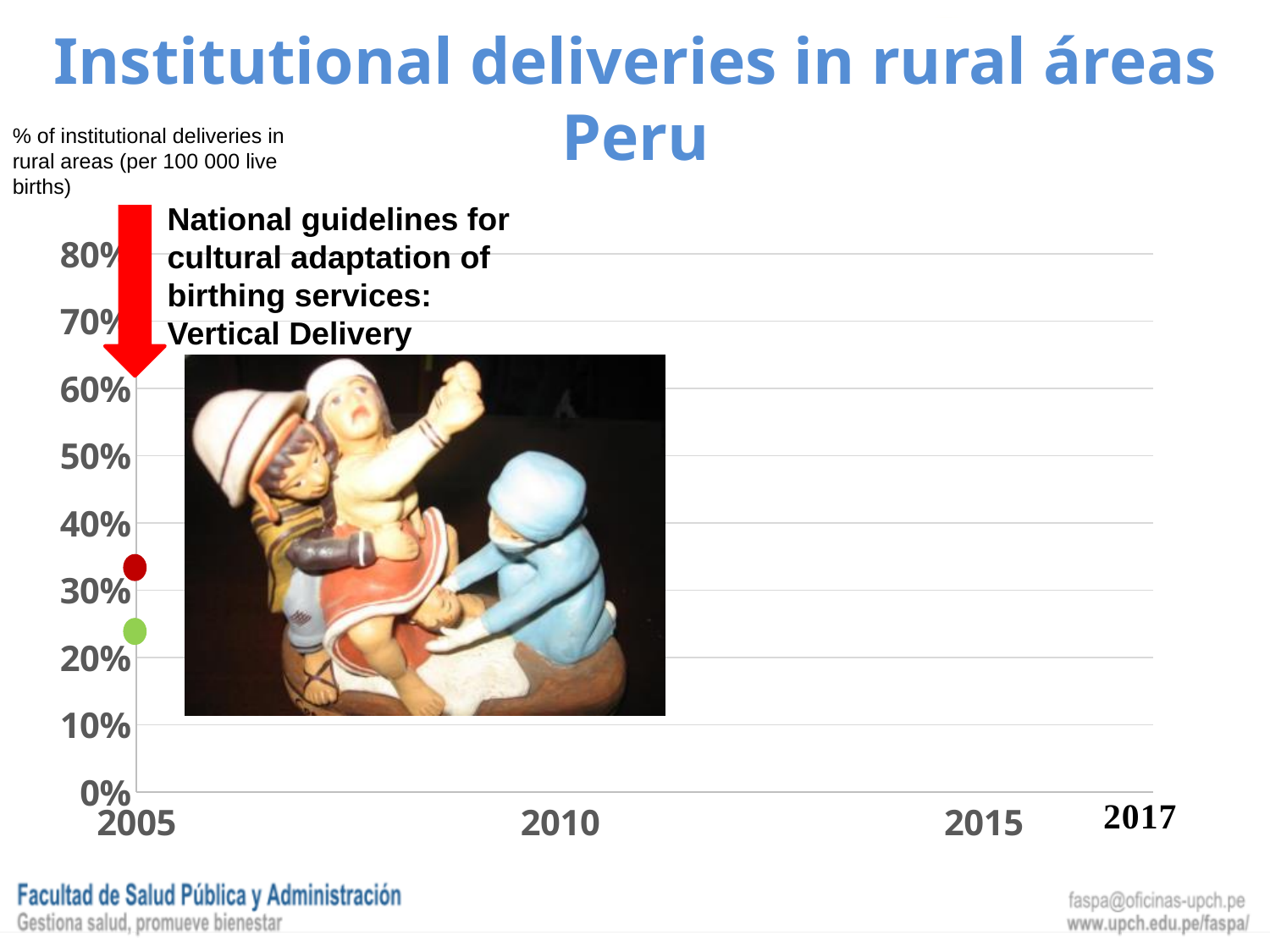
Which of the two points plotted at 2005 is higher, the red point or the green point? the red point What is the first year shown on the chart's horizontal axis? 2005 Is the value of the green point at 2005 greater or less than 30%? less How many year labels are shown along the chart's horizontal axis? 4 What is the title of the chart on the slide? Institutional deliveries in rural áreas Peru How many data points are plotted at the year 2005? 2 What is the highest value shown on the chart's vertical axis? 80% Is the value of the green point at 2005 greater or less than 20%? greater Is the value of the red point at 2005 greater or less than 40%? less